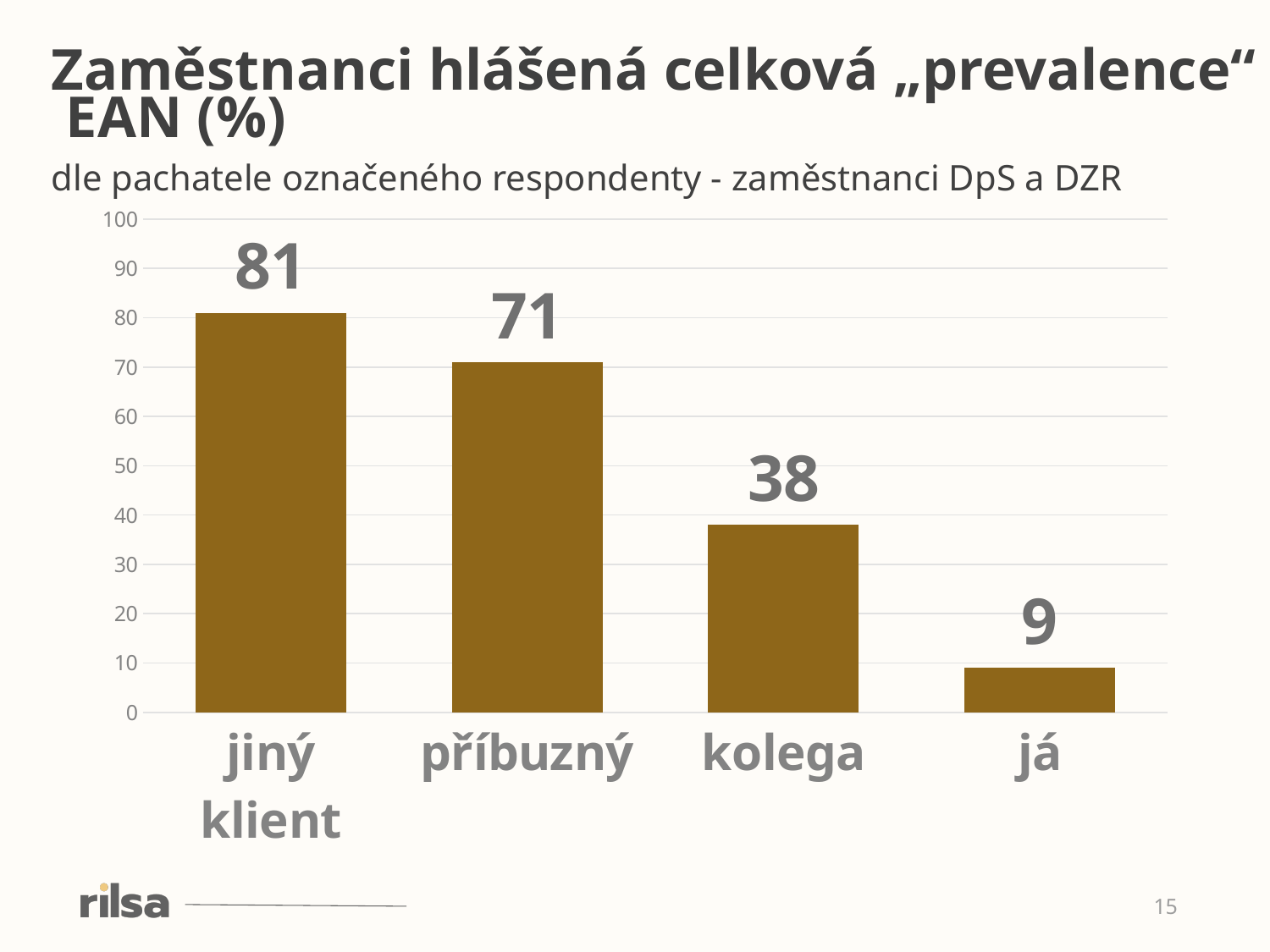
What is the value for "jiný klient"? 81 What is the value for "já"? 9 Which category has the highest value? jiný klient Which is larger, the value for "příbuzný" or the value for "kolega"? příbuzný Which category has the lowest value? já What is the value for "kolega"? 38 What is the value for "příbuzný"? 71 What is the difference between the values for "jiný klient" and "příbuzný"? 10 Do the values rise or fall from left to right along the x axis? fall What is the difference between the values for "kolega" and "já"? 29 What kind of chart is shown on the slide? bar chart How many categories are shown on the x axis? 4